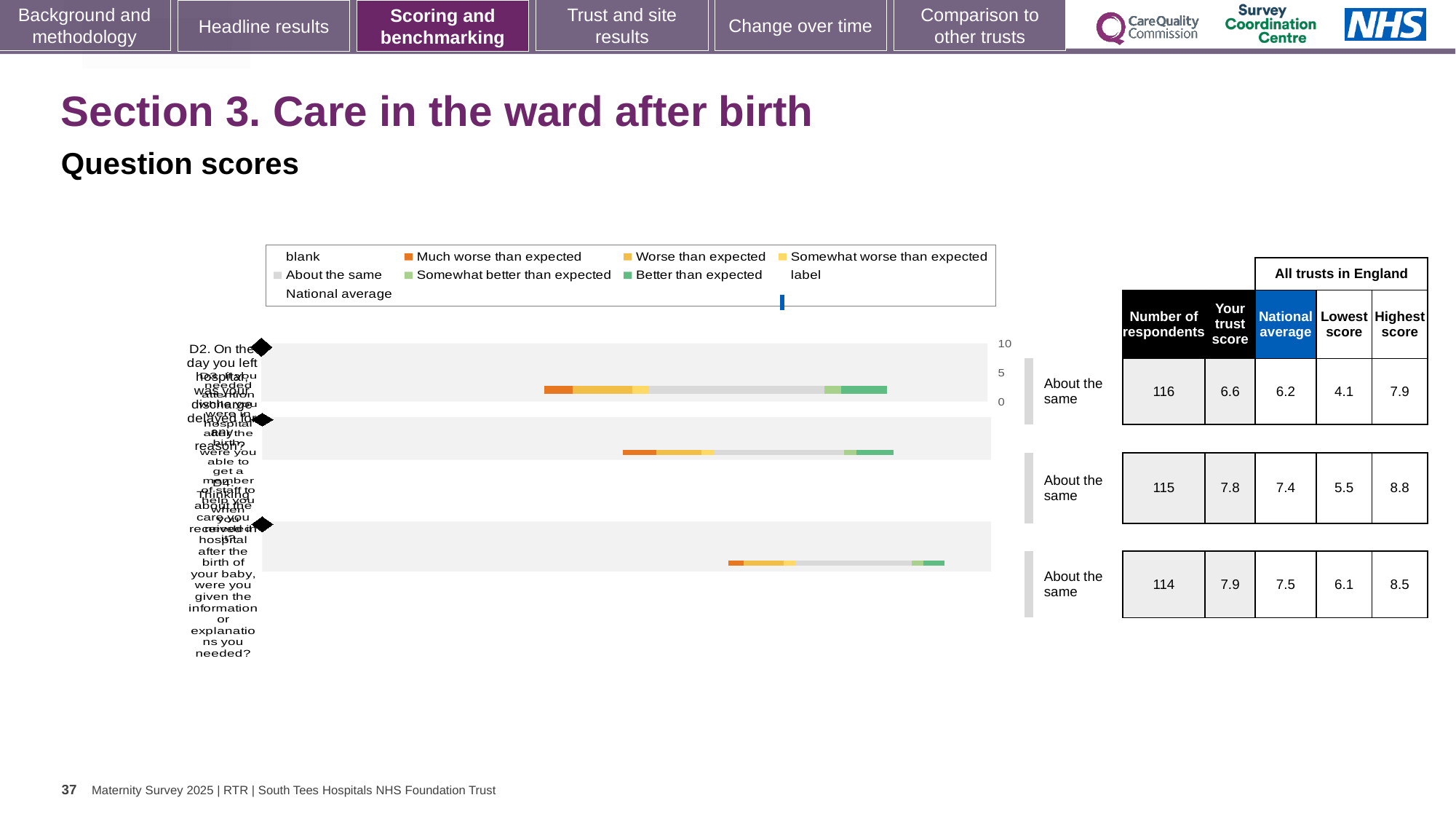
What kind of chart is shown on the slide? bar chart In the table beside the chart, what is the national average for the second row? 7.4 In the table beside the chart, what is the number of respondents for the first row? 116 In the table beside the chart, which row has the highest 'Your trust score'? the third row (7.9) In the table beside the chart, for the second row, which is larger: 'Your trust score' or the national average? Your trust score In the table beside the chart, what is 'Your trust score' for the first row? 6.6 In the table beside the chart, what is the highest score for the third row? 8.5 What is the highest tick value shown on the chart's numeric axis? 10 In the chart legend, which colour represents 'Better than expected'? green In the chart legend, which colour represents 'Much worse than expected'? orange In the table beside the chart, what is the difference between the highest score and the lowest score in the first row? 3.8 How many bars are plotted in the chart? 3